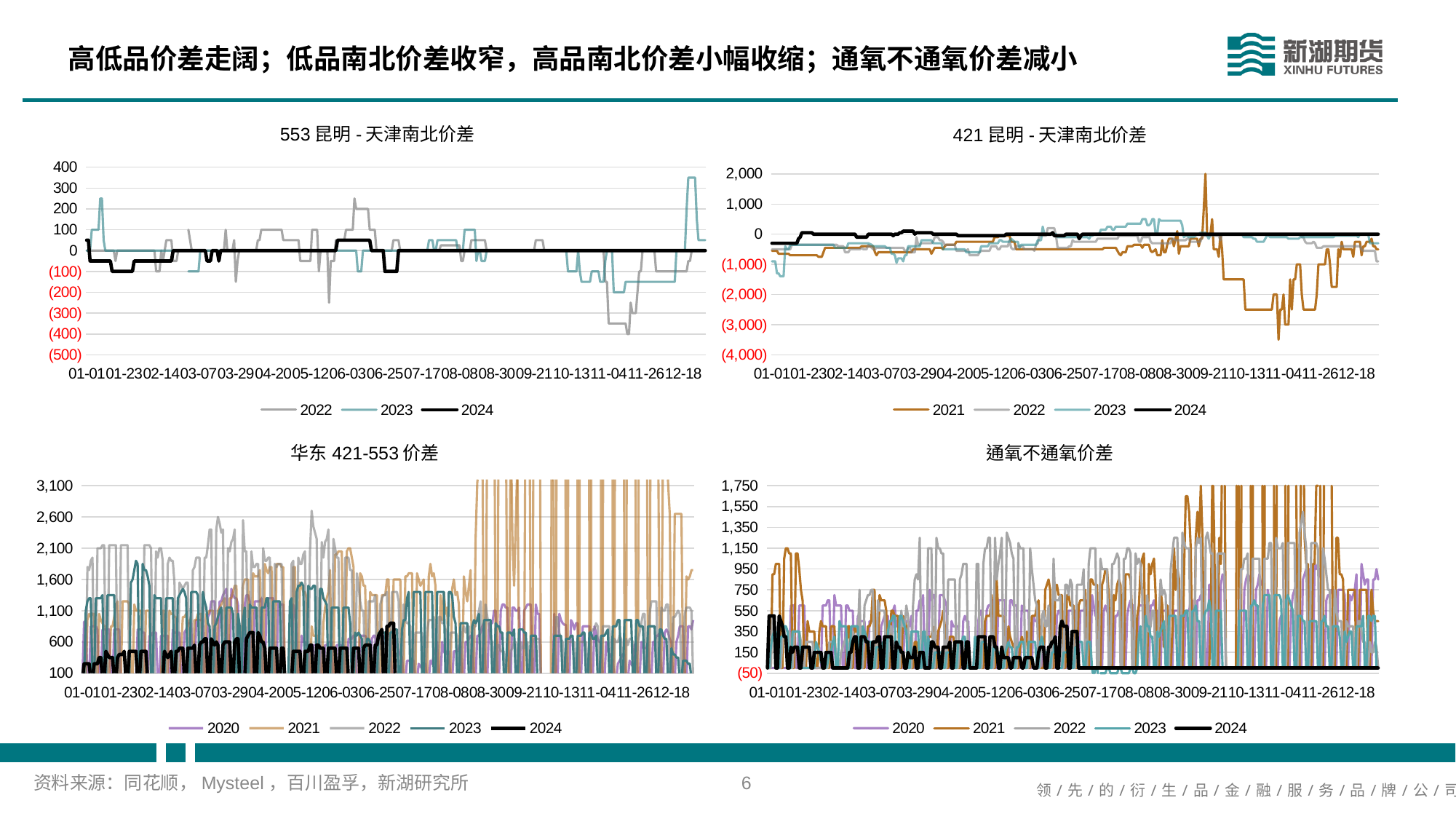
What kind of chart is the bottom-right chart titled 通氧不通氧价差? line chart How many series does the legend of the top-left chart (553 昆明 - 天津南北价差) list? 3 How many series does the legend of the top-right chart (421 昆明 - 天津南北价差) list? 4 In the top-left chart (553 昆明 - 天津南北价差), is the highest value of the 2023 series greater or less than 200? greater What is the title of the bottom-right chart? 通氧不通氧价差 In the top-left chart (553 昆明 - 天津南北价差), is the lowest value of the 2022 series greater or less than (300)? less In the bottom-left chart (华东 421-553 价差), is the highest value of the 2024 series greater or less than 1,100? less How many series does the legend of the bottom-left chart (华东 421-553 价差) list? 5 Which series is missing from the legend of the top-left chart (553 昆明 - 天津南北价差) but present in the top-right chart (421 昆明 - 天津南北价差)? 2021 What kind of chart is the top-left chart titled 553 昆明 - 天津南北价差? line chart